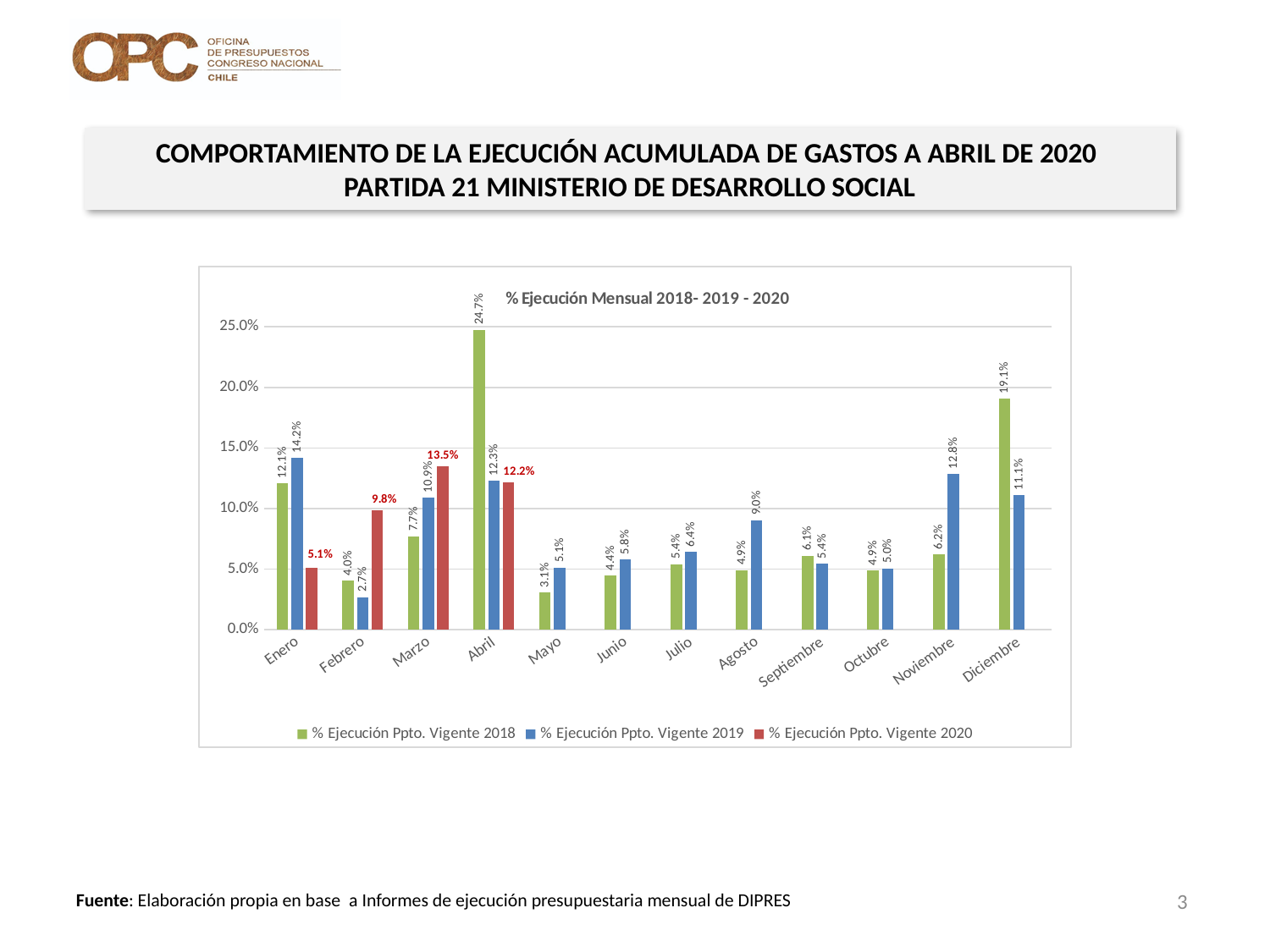
In which month is the % Ejecución Ppto. Vigente 2018 value highest? Abril What is the value for % Ejecución Ppto. Vigente 2020 in Marzo? 13.5% In which month is the % Ejecución Ppto. Vigente 2019 value lowest? Febrero Is the value for % Ejecución Ppto. Vigente 2018 in Diciembre greater or less than 15.0%? greater Which is larger in Febrero: the 2020 value or the 2018 value? The 2020 value What is the difference between the 2019 and 2018 values in Enero? 2.1% What is the value for % Ejecución Ppto. Vigente 2018 in Abril? 24.7% What is the title of the chart? % Ejecución Mensual 2018- 2019 - 2020 How many series does the legend list? 3 What is the value for % Ejecución Ppto. Vigente 2019 in Noviembre? 12.8% What type of chart is shown on the slide? Bar chart How many months are shown on the x axis? 12